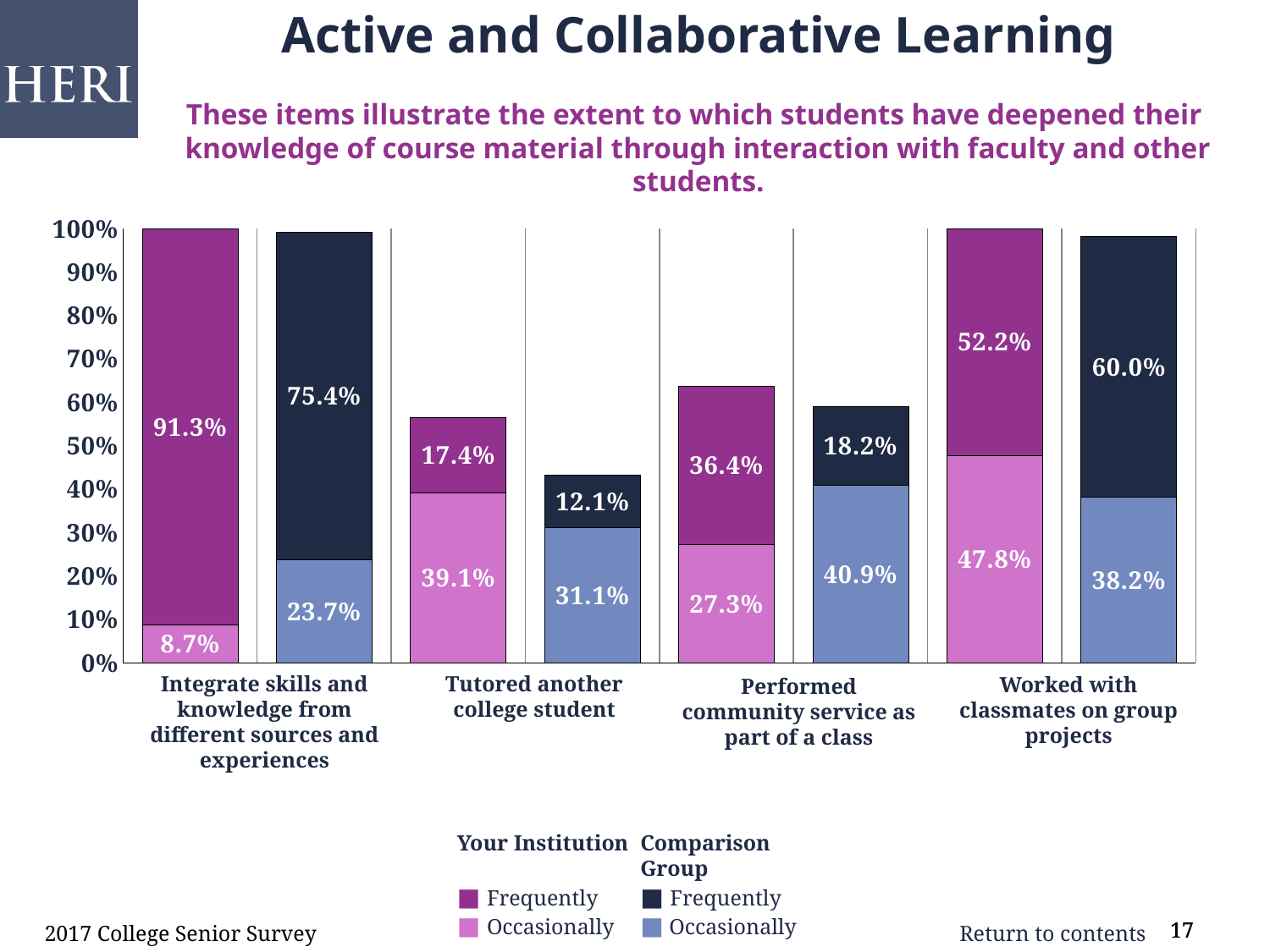
What is the Comparison Group 'Occasionally' value for 'Tutored another college student'? 31.1% Which is larger for 'Worked with classmates on group projects': the Your Institution 'Frequently' value or the Comparison Group 'Frequently' value? Comparison Group (60.0%) What is the difference between the Your Institution and Comparison Group 'Frequently' values for 'Integrate skills and knowledge from different sources and experiences'? 15.9% Across the four items, which has the highest Comparison Group 'Occasionally' value? Performed community service as part of a class What is the Your Institution 'Occasionally' value for 'Worked with classmates on group projects'? 47.8% What percentage of students at Your Institution reported 'Frequently' for 'Integrate skills and knowledge from different sources and experiences'? 91.3% How many items (categories) are shown on the x axis of the chart? 4 What is the total of the Comparison Group stacked bar for 'Performed community service as part of a class'? 59.1% What type of chart is shown on the slide? Stacked bar chart Across the four items, which has the lowest Your Institution 'Frequently' value? Tutored another college student What is the Comparison Group 'Frequently' value for 'Performed community service as part of a class'? 18.2% What is the total of the Your Institution stacked bar for 'Tutored another college student'? 56.5%